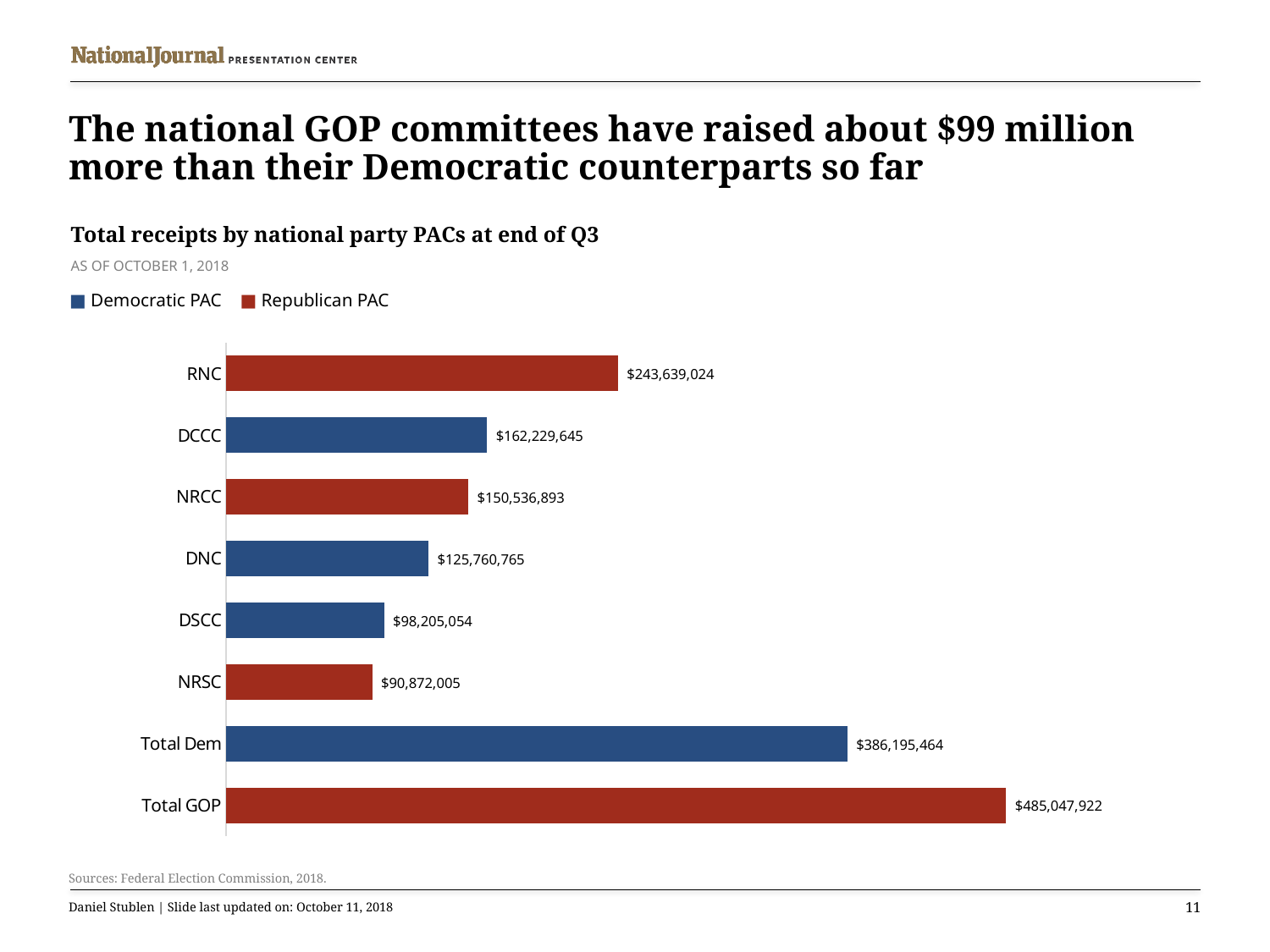
What is the value for the NRSC? $90,872,005 What is the difference between the DSCC and the NRSC? $7,333,049 Which is larger, the value for the DNC or the value for the NRCC? NRCC How many categories are shown in the chart? 8 What is the value for the RNC? $243,639,024 Which category has the lowest value? NRSC How many series does the legend list? 2 What is the value for the DCCC? $162,229,645 What kind of chart is shown on the slide? Bar chart What is the difference between Total GOP and Total Dem? $98,852,458 Which category has the highest value? Total GOP What is the value for Total Dem? $386,195,464